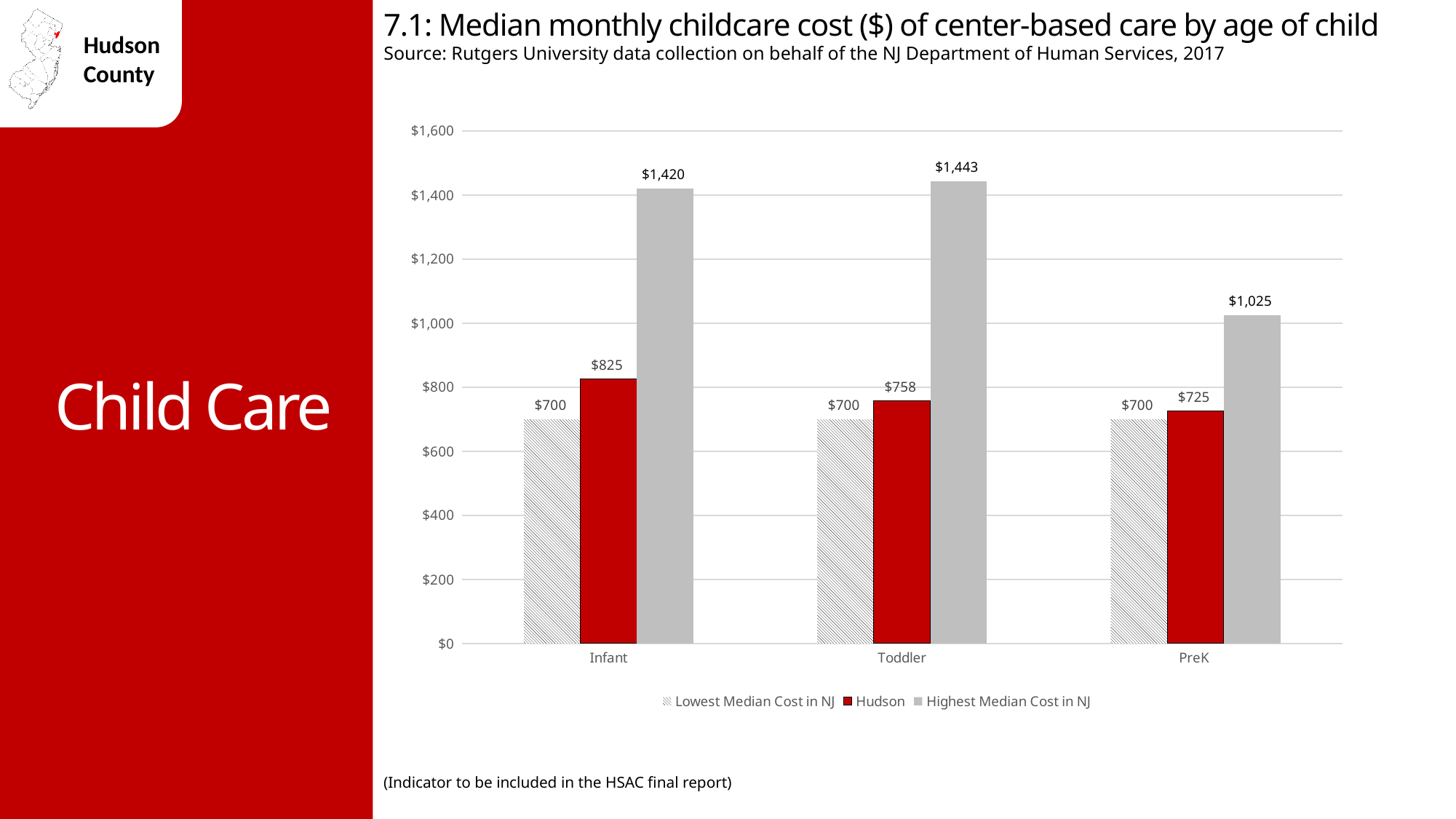
How many series does the legend list? 3 What is the difference between the Hudson cost for Toddler care and the Hudson cost for PreK care? $33 What is the difference between the Highest Median Cost in NJ and the Hudson cost for Infant care? $595 Is the Hudson value for PreK care greater or less than $800? less What is the Highest Median Cost in NJ for Toddler care? $1,443 Which is larger, the Highest Median Cost in NJ for Infant care or for Toddler care? Toddler What kind of chart is shown on the slide? bar chart How many age groups are shown on the x axis? 3 What is the Hudson median monthly childcare cost for Infant care? $825 Which age group has the highest Hudson median monthly cost? Infant Which age group has the lowest Highest Median Cost in NJ? PreK What is the Lowest Median Cost in NJ for PreK care? $700